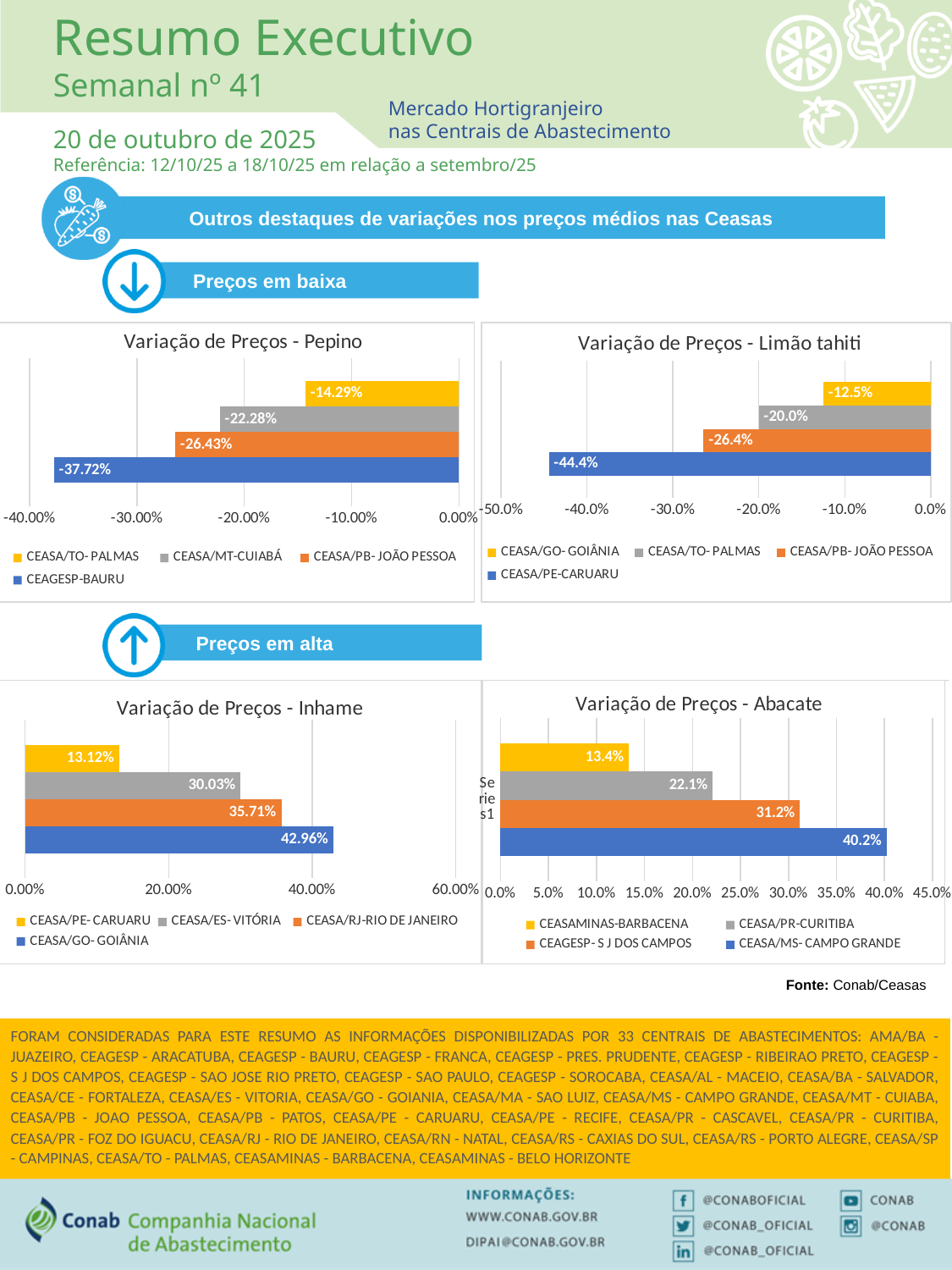
In the 'Variação de Preços - Inhame' chart, which series has the highest value? CEASA/GO- GOIÂNIA In the 'Variação de Preços - Pepino' chart, which series has the smallest price decrease (value closest to zero)? CEASA/TO- PALMAS What type of chart is 'Variação de Preços - Limão tahiti'? Bar chart In the 'Variação de Preços - Limão tahiti' chart, what is the difference between the values for CEASA/GO- GOIÂNIA and CEASA/TO- PALMAS? 7.5 percentage points In the 'Variação de Preços - Abacate' chart, is the value for CEASA/MS- CAMPO GRANDE greater or less than 35.0%? greater In the 'Variação de Preços - Pepino' chart, what is the value for CEAGESP-BAURU? -37.72% How many series does the legend of the 'Variação de Preços - Pepino' chart list? 4 In the 'Variação de Preços - Inhame' chart, which series has the lowest value? CEASA/PE- CARUARU In the 'Variação de Preços - Limão tahiti' chart, what is the value for CEASA/PE-CARUARU? -44.4% In the 'Variação de Preços - Abacate' chart, what is the value for CEAGESP- S J DOS CAMPOS? 31.2% In the 'Variação de Preços - Abacate' chart, which is larger: the value for CEASA/PR-CURITIBA or CEASAMINAS-BARBACENA? CEASA/PR-CURITIBA In the 'Variação de Preços - Inhame' chart, what is the value for CEASA/ES- VITÓRIA? 30.03%